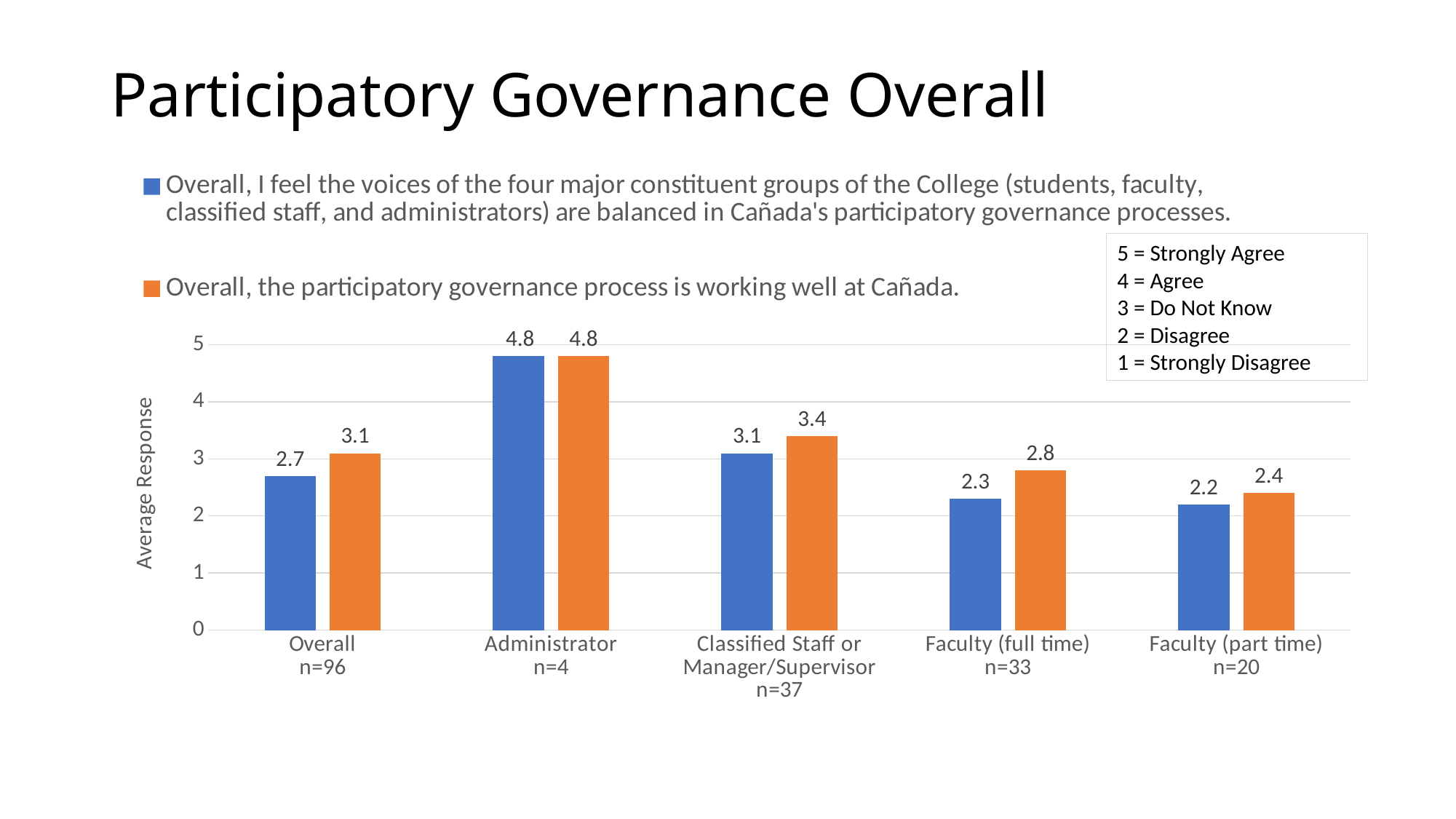
What is the difference between the two average responses for Faculty (full time)? 0.5 What is the average response for Faculty (part time) on the statement that the participatory governance process is working well? 2.4 How many series does the legend list? 2 What is the label of the vertical axis? Average Response Which group has the lowest average response on the statement that the voices of the four major constituent groups are balanced? Faculty (part time) How many groups are shown on the x axis of the chart? 5 What is the average response for Administrator on the statement that the participatory governance process is working well at Cañada? 4.8 Is the average response for Faculty (full time) on the statement that the voices are balanced greater or less than 3? less What is the average response for Overall (n=96) on the statement that the voices of the four major constituent groups are balanced? 2.7 For Classified Staff or Manager/Supervisor, which statement has the higher average response: the voices are balanced, or the process is working well? The process is working well Which group has the highest average response on the statement that the participatory governance process is working well? Administrator What kind of chart is shown on the slide? Bar chart